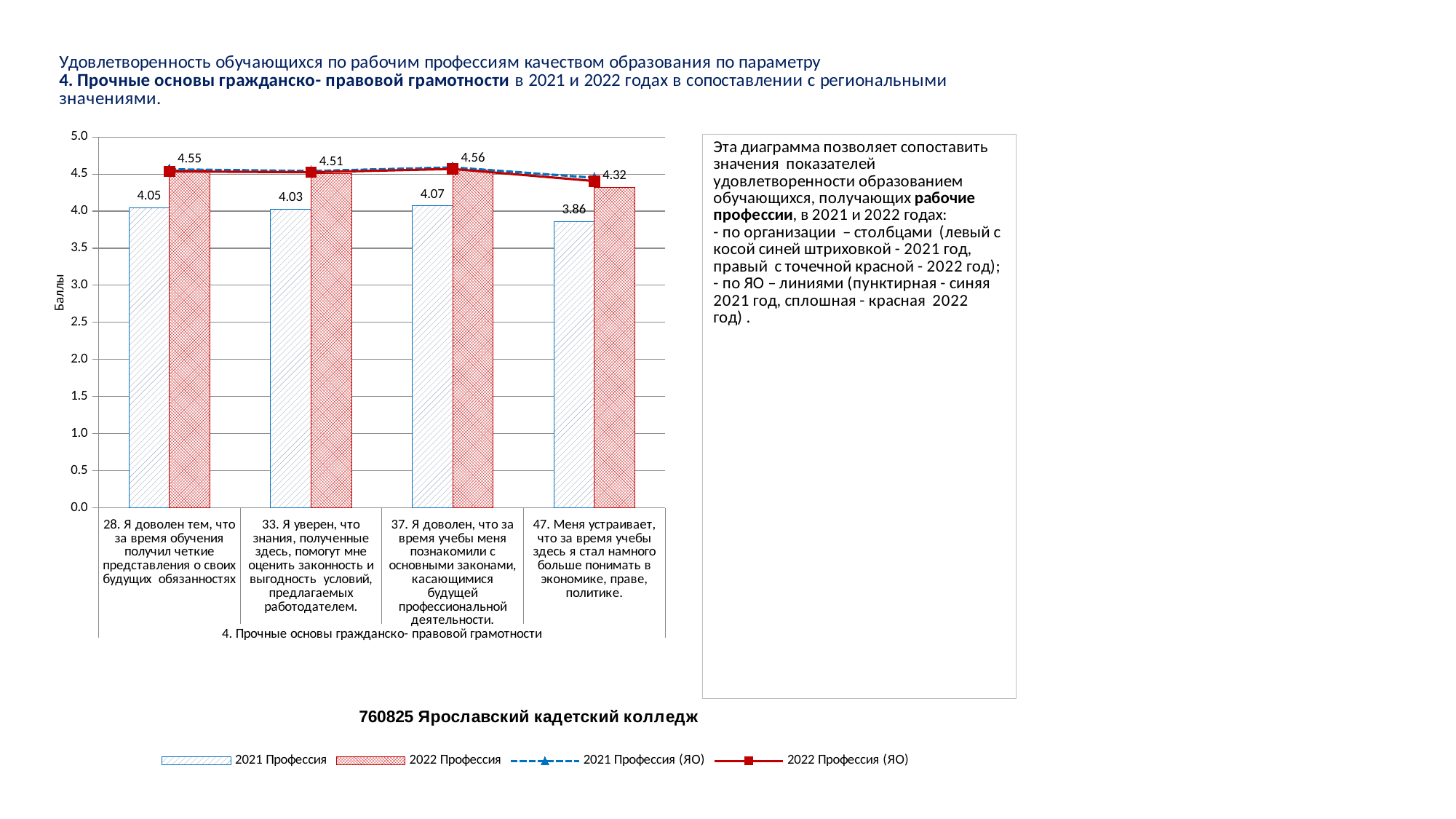
Which question has the highest 2022 Профессия value? 37. Я доволен, что за время учебы меня познакомили с основными законами, касающимися будущей профессиональной деятельности. How many series does the chart legend list? 4 Which question has the lowest 2021 Профессия value? 47. Меня устраивает, что за время учебы здесь я стал намного больше понимать в экономике, праве, политике. What type of chart is used to show the organisation's values (2021 Профессия and 2022 Профессия)? bar chart What is the difference between the 2022 Профессия and 2021 Профессия values for question 37? 0.49 For question 47, which is larger: the 2021 Профессия value or the 2022 Профессия value? 2022 Профессия What is the label of the y axis of the chart? Баллы How many questions (categories) are shown on the x axis of the chart? 4 Is the 2021 Профессия value for question 47 greater or less than 4.0? less What is the 2021 Профессия value for question 28 (Я доволен тем, что за время обучения получил четкие представления о своих будущих обязанностях)? 4.05 What is the 2022 Профессия value for question 33 (Я уверен, что знания, полученные здесь, помогут мне оценить законность и выгодность условий, предлагаемых работодателем)? 4.51 What is the 2022 Профессия value for question 47 (Меня устраивает, что за время учебы здесь я стал намного больше понимать в экономике, праве, политике)? 4.32